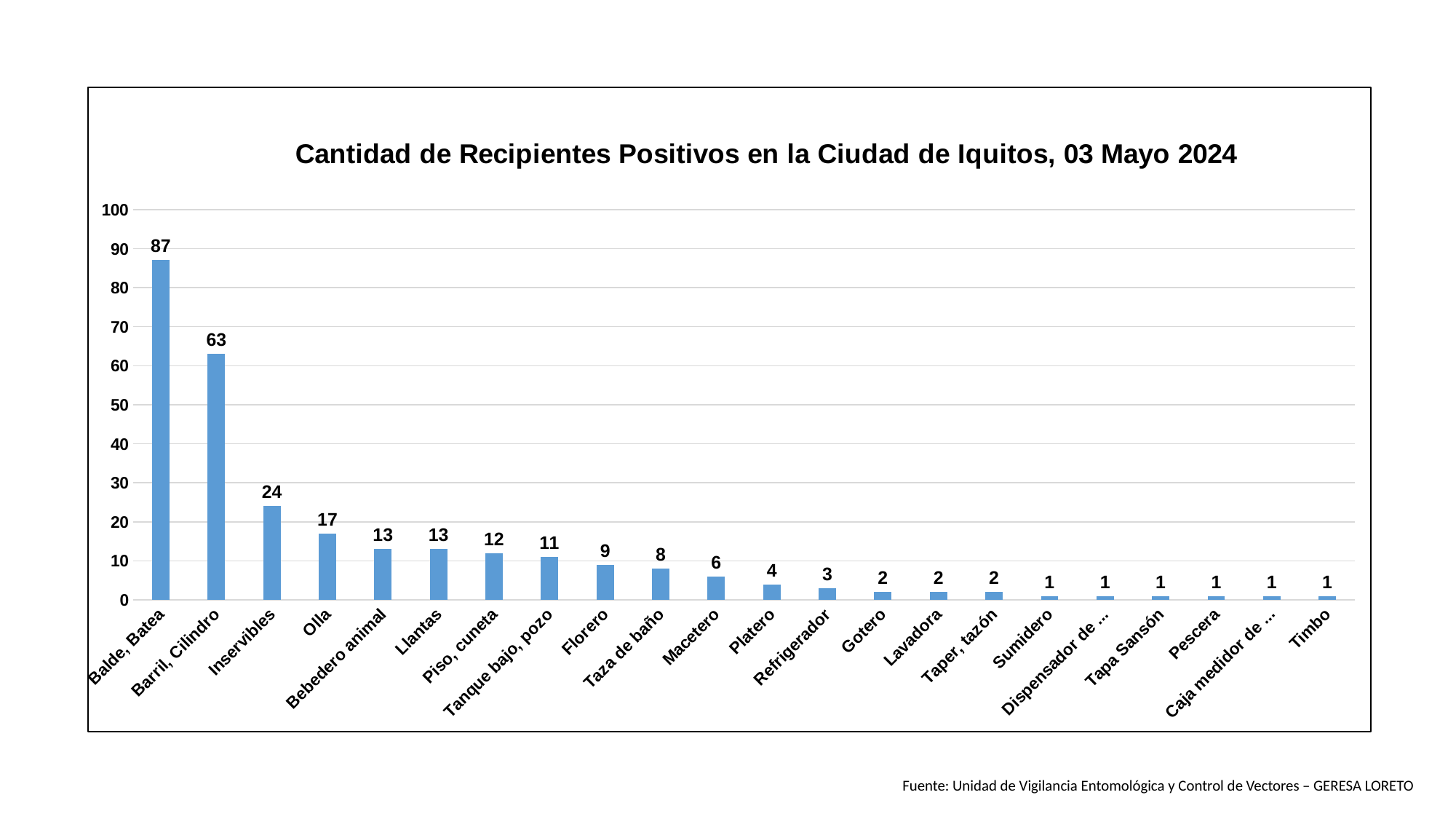
Is the value for Barril, Cilindro greater or less than 50? greater What is the value for Florero? 9 What is the value for Refrigerador? 3 Which category has the highest value? Balde, Batea Which is larger, the value for Piso, cuneta or the value for Taza de baño? Piso, cuneta What is the difference between the values for Balde, Batea and Barril, Cilindro? 24 What is the title of the chart? Cantidad de Recipientes Positivos en la Ciudad de Iquitos, 03 Mayo 2024 What is the value for Inservibles? 24 What kind of chart is shown on the slide? bar chart What is the difference between the values for Olla and Macetero? 11 What is the value for Balde, Batea? 87 How many categories are shown on the x axis? 22